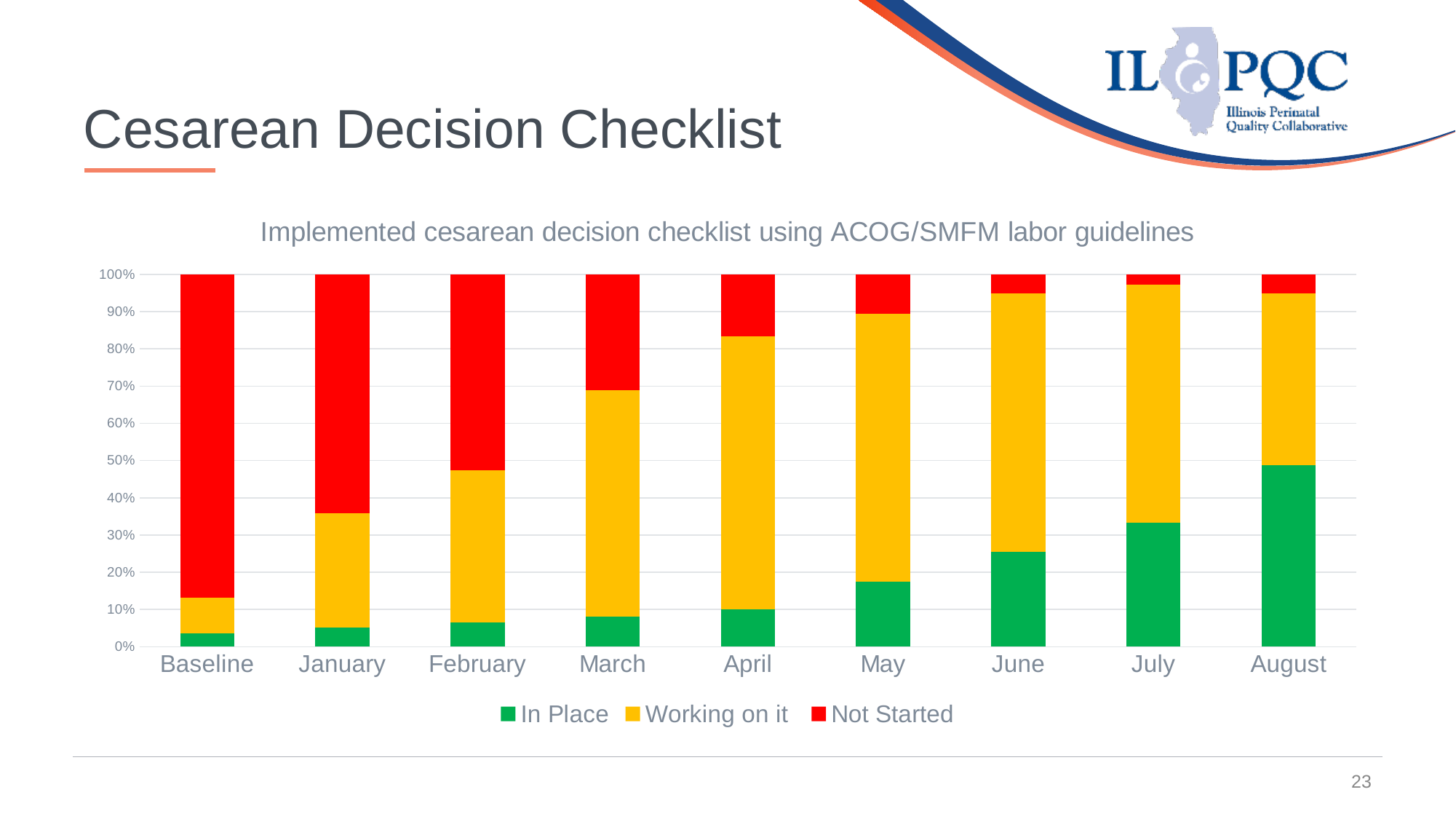
Is the 'In Place' value for August greater or less than 40%? greater What kind of chart is shown on the slide? Stacked bar chart Is the 'Not Started' value for Baseline greater or less than 80%? greater How many categories are shown along the x axis of the chart? 9 Which series is shown in green in the chart? In Place Which category has the smallest 'In Place' share? Baseline Does the 'In Place' share rise or fall from Baseline to August? rise How many series does the chart legend list? 3 Which is larger, the 'In Place' share for July or for January? July Which category has the largest 'In Place' share? August Which category has the largest 'Not Started' share? Baseline What is the title of the chart? Implemented cesarean decision checklist using ACOG/SMFM labor guidelines